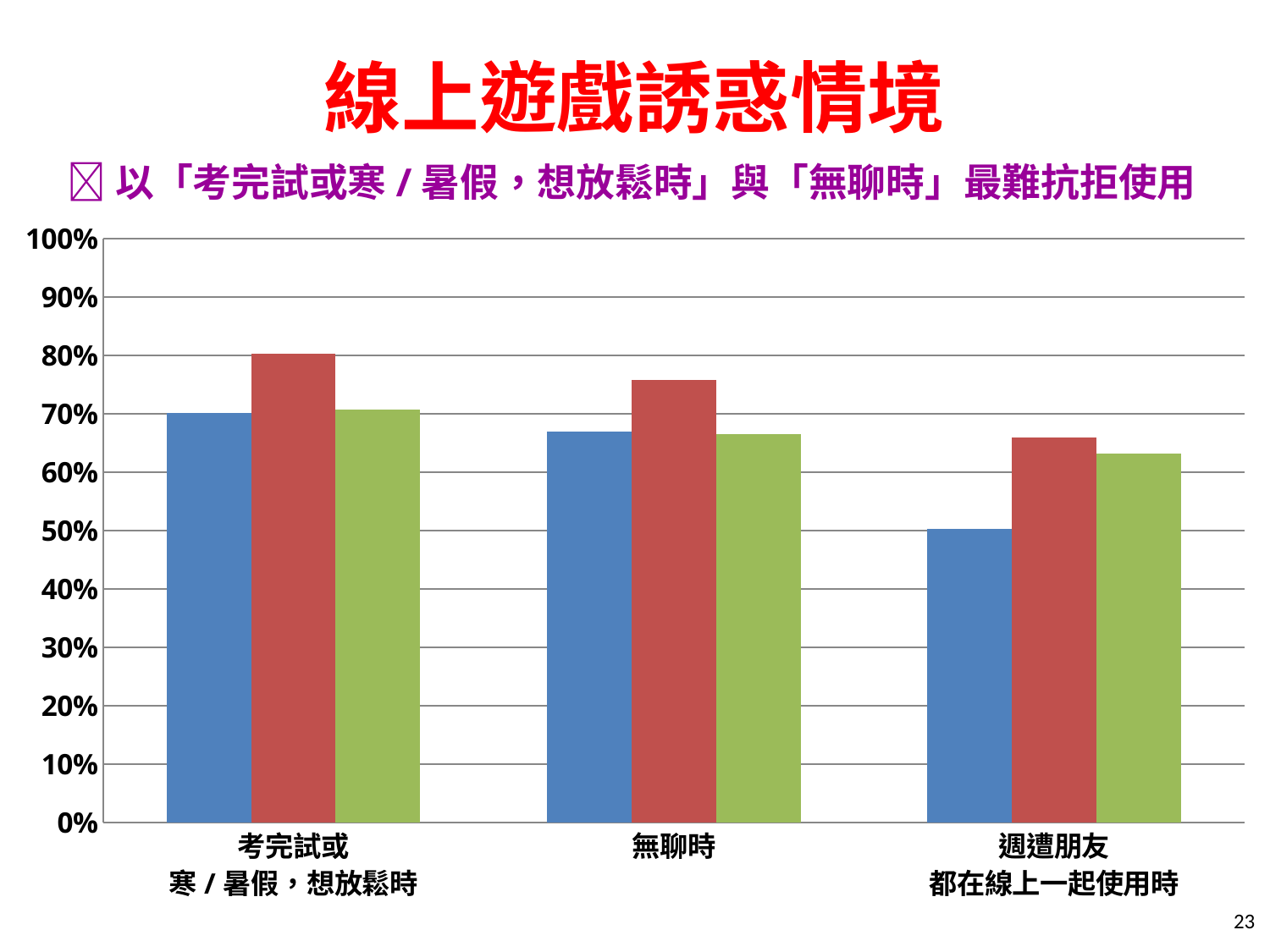
Is the green bar for 週遭朋友都在線上一起使用時 greater or less than 60%? greater What kind of chart is shown on the slide? bar chart How many categories are shown on the x axis of the chart? 3 Is the red bar for 無聊時 greater or less than 70%? greater Which category has the tallest bar in the chart? 考完試或寒／暑假，想放鬆時 Do the blue bars rise or fall from left to right across the categories? fall Which is larger: the blue bar for 考完試或寒／暑假，想放鬆時 or the blue bar for 週遭朋友都在線上一起使用時? 考完試或寒／暑假，想放鬆時 Is the red bar for 週遭朋友都在線上一起使用時 greater or less than 70%? less What is the highest value shown on the y axis of the chart? 100% Which coloured bar is the tallest within every category? red Which category has the shortest bar in the chart? 週遭朋友都在線上一起使用時 How many bars are shown for each category in the chart? 3